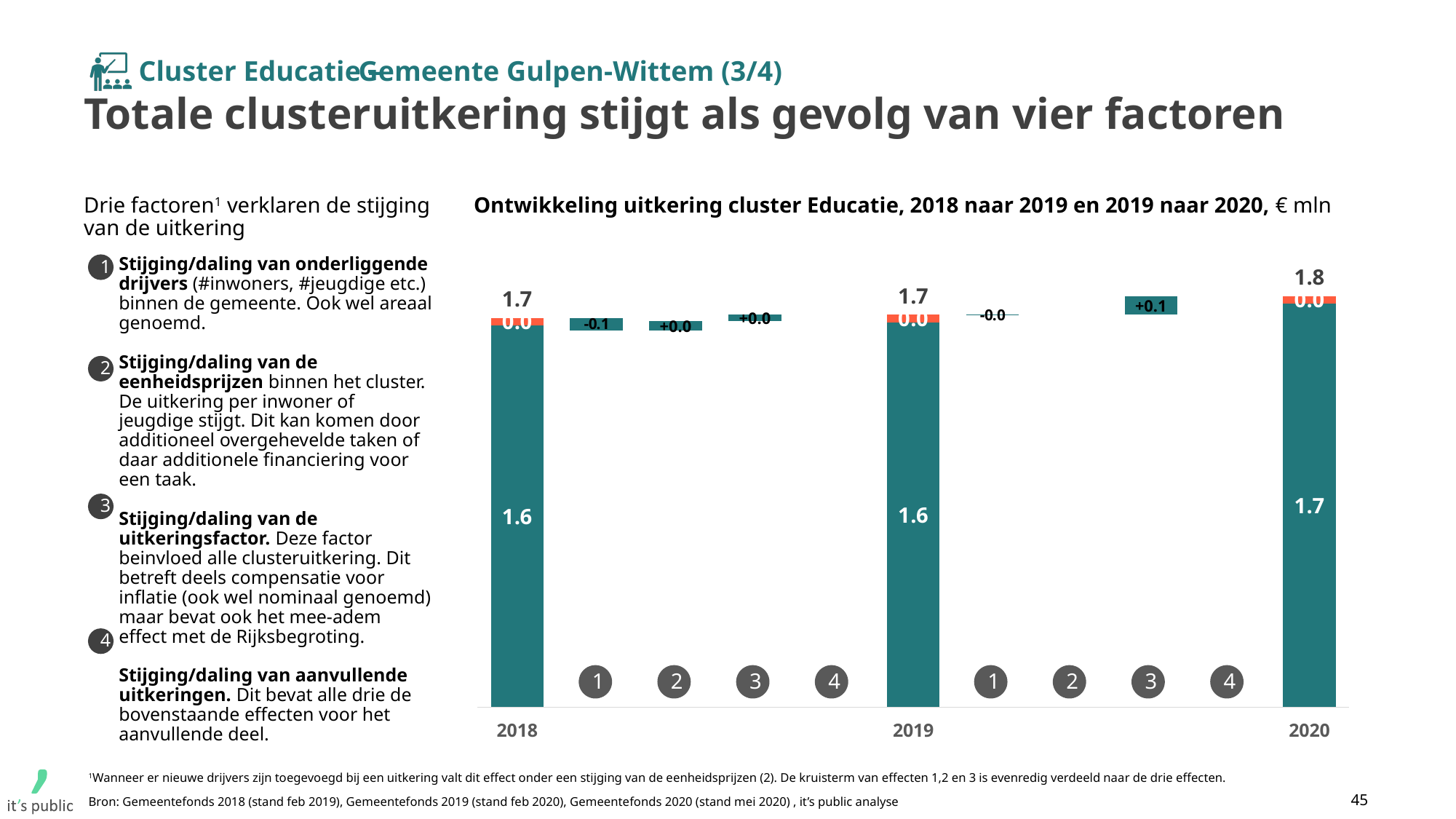
What is the total uitkering for 2018 shown above the bar? 1.7 In what unit are the values in the chart expressed, according to the chart title? € mln What is the value of the large teal segment of the 2019 bar? 1.6 What is the value labelled for factor 1 between 2018 and 2019? -0.1 What is the value labelled for factor 3 between 2019 and 2020? +0.1 What is the total uitkering for 2020 shown above the bar? 1.8 Is the 2020 total larger or smaller than the 2019 total? larger What is the value of the large teal segment of the 2020 bar? 1.7 What is the value labelled for factor 1 between 2019 and 2020? -0.0 Which year has the highest total uitkering? 2020 How many year totals (full bars) are shown in the chart? 3 What is the difference between the 2020 total and the 2018 total? 0.1